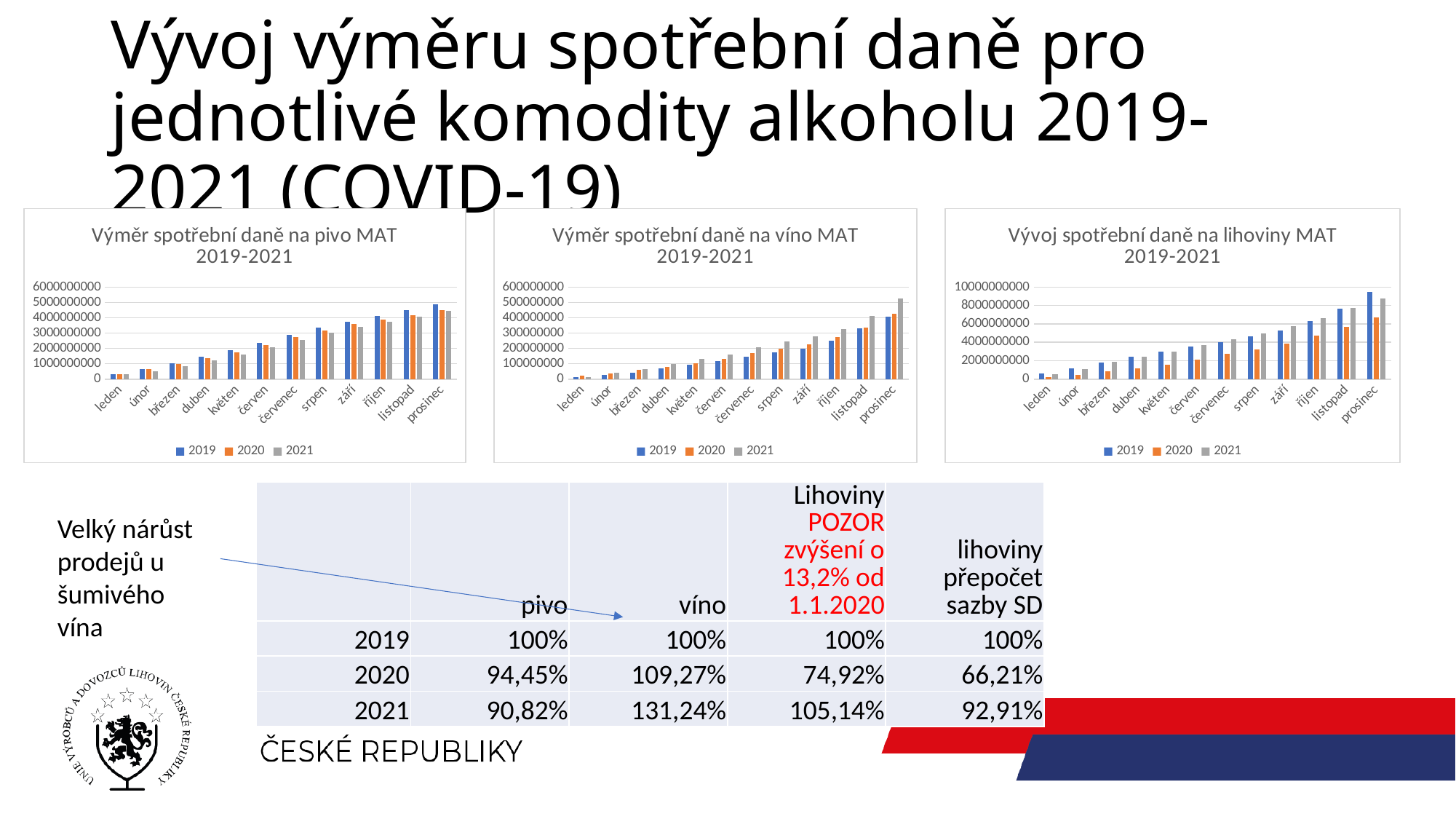
What is the title of the rightmost chart on the slide? Vývoj spotřební daně na lihoviny MAT 2019-2021 In the chart titled "Vývoj spotřební daně na lihoviny MAT 2019-2021", which is larger for prosinec: the 2019 value or the 2020 value? 2019 In the chart titled "Výměr spotřební daně na víno MAT 2019-2021", is the 2021 value for prosinec greater or less than 500000000? greater In the chart titled "Výměr spotřební daně na pivo MAT 2019-2021", is the 2021 value for leden greater or less than 1000000000? less How many series does the legend of the chart titled "Výměr spotřební daně na víno MAT 2019-2021" list? 3 How many month categories are shown on the x axis of the chart titled "Vývoj spotřební daně na lihoviny MAT 2019-2021"? 12 In the chart titled "Výměr spotřební daně na pivo MAT 2019-2021", is the 2019 value for prosinec greater or less than 4000000000? greater What are the legend entries of the chart titled "Výměr spotřební daně na pivo MAT 2019-2021"? 2019, 2020, 2021 In the chart titled "Vývoj spotřební daně na lihoviny MAT 2019-2021", do the 2019 values rise or fall from leden to prosinec? rise In the chart titled "Výměr spotřební daně na víno MAT 2019-2021", which is larger for prosinec: the 2019 value or the 2021 value? 2021 What kind of chart is the chart titled "Výměr spotřební daně na pivo MAT 2019-2021"? bar chart